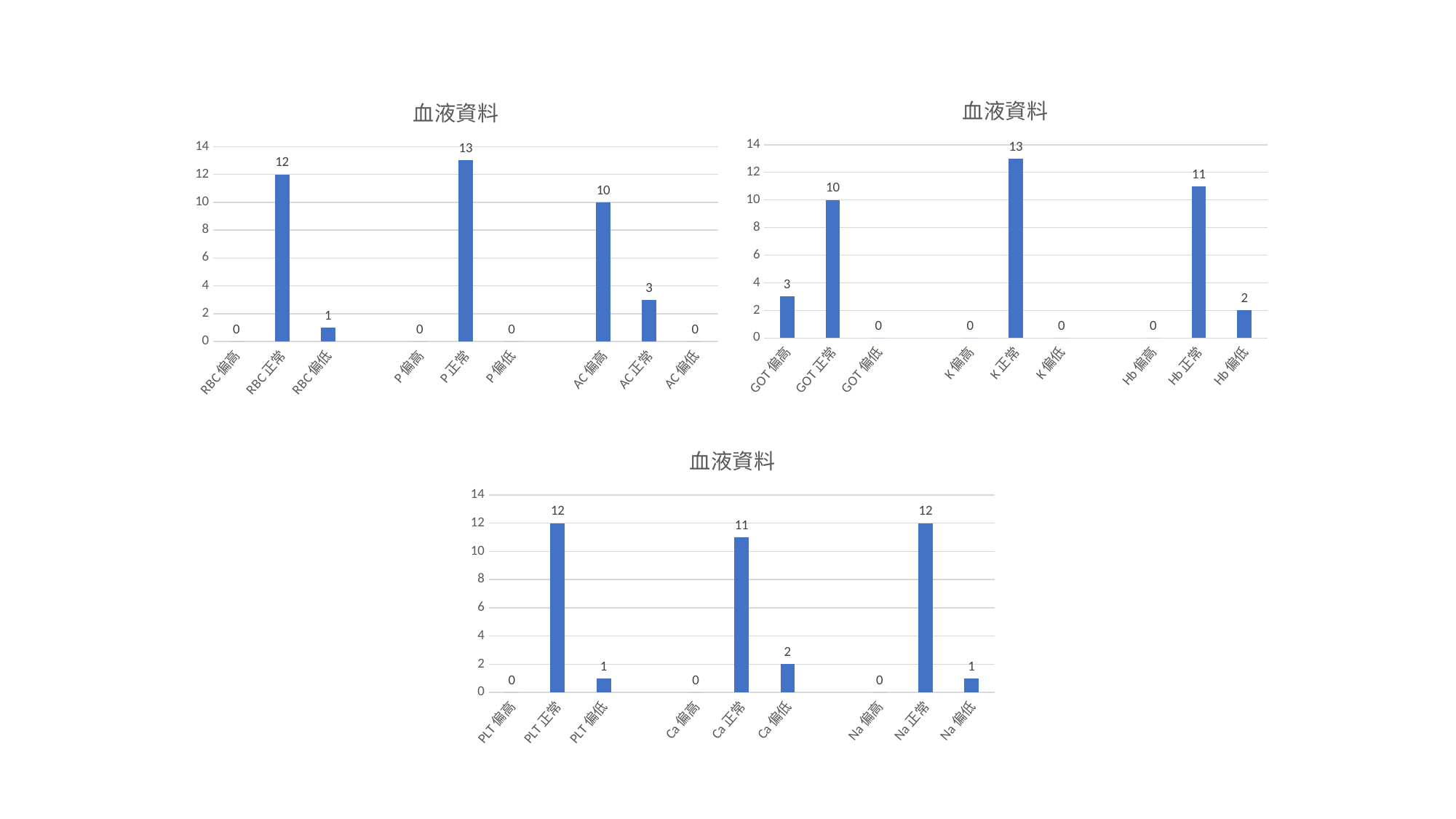
In the top-left chart, what is the difference between P 正常 and AC 正常? 10 In the top-left chart, what is the value for AC 偏高? 10 In the top-right chart, what is the difference between Hb 正常 and Hb 偏低? 9 What kind of chart is the bottom chart? Bar chart In the bottom chart, how many categories are shown on the x axis? 9 In the top-right chart, what is the value for GOT 偏高? 3 In the bottom chart, what is the total of PLT 偏高, PLT 正常 and PLT 偏低? 13 In the top-left chart, which category has the highest value? P 正常 In the top-right chart, which category has the highest value? K 正常 In the bottom chart, what is the value for Ca 偏低? 2 In the top-left chart, what is the value for RBC 正常? 12 In the top-right chart, which is larger, Hb 正常 or GOT 正常? Hb 正常